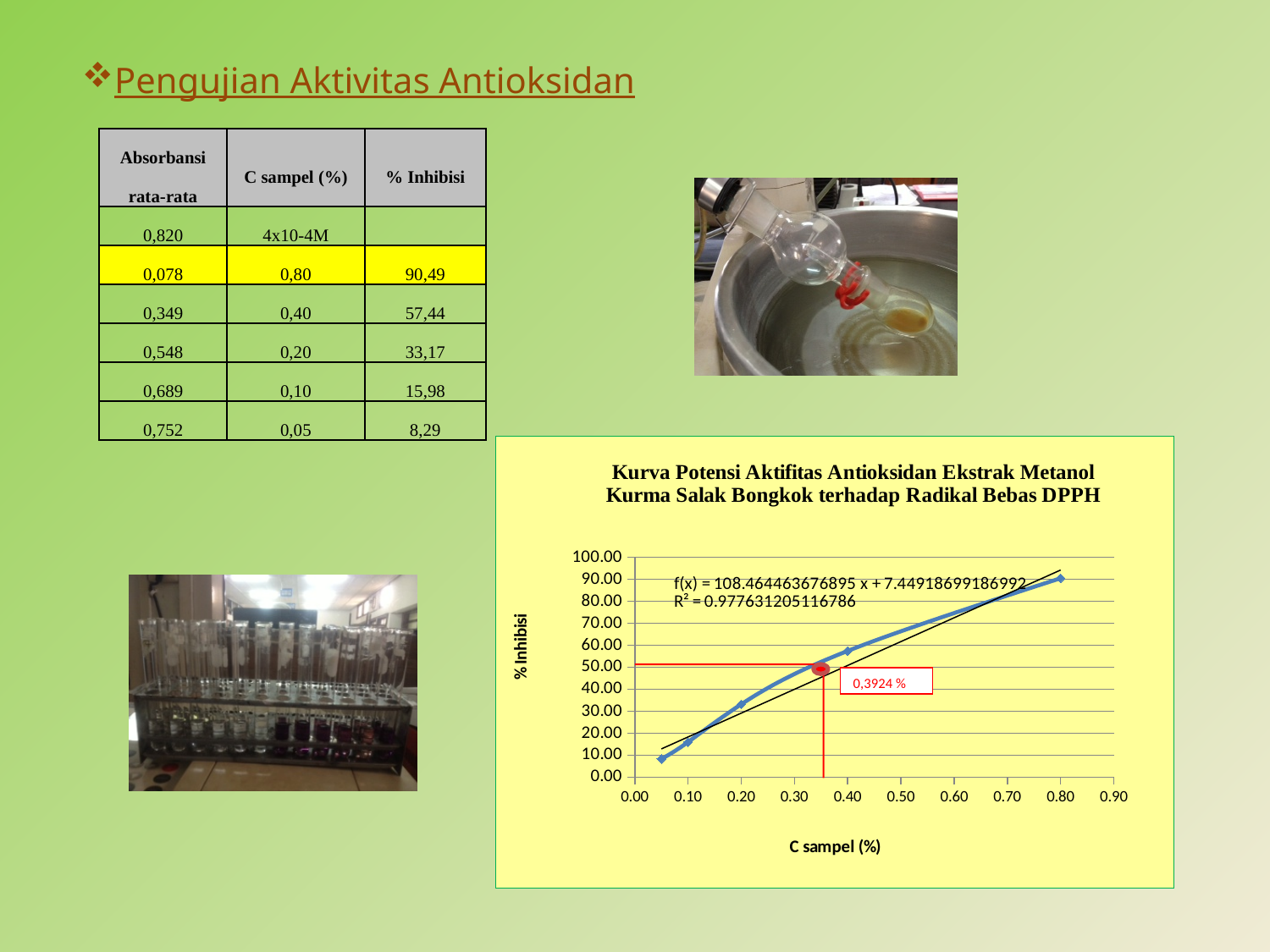
In the chart, is the % Inhibisi value at C sampel 0.10 greater or less than 20.00? less In the chart, is the % Inhibisi value at C sampel 0.40 larger or smaller than the value at C sampel 0.20? larger In the chart, does % Inhibisi rise or fall as C sampel (%) increases? rise What value is shown in the red-bordered annotation box on the chart? 0,3924 % In the chart, at which C sampel (%) value is % Inhibisi highest? 0.80 In the chart, is the % Inhibisi value at C sampel 0.80 greater or less than 80.00? greater In the chart, is the % Inhibisi value at C sampel 0.40 greater or less than 50.00? greater What kind of chart is shown under the title 'Kurva Potensi Aktifitas Antioksidan Ekstrak Metanol Kurma Salak Bongkok terhadap Radikal Bebas DPPH'? line chart In the chart, at which C sampel (%) value is % Inhibisi lowest? 0.05 How many data points are plotted on the blue line in the chart? 5 What R² value is printed on the chart for the trendline? 0.977631205116786